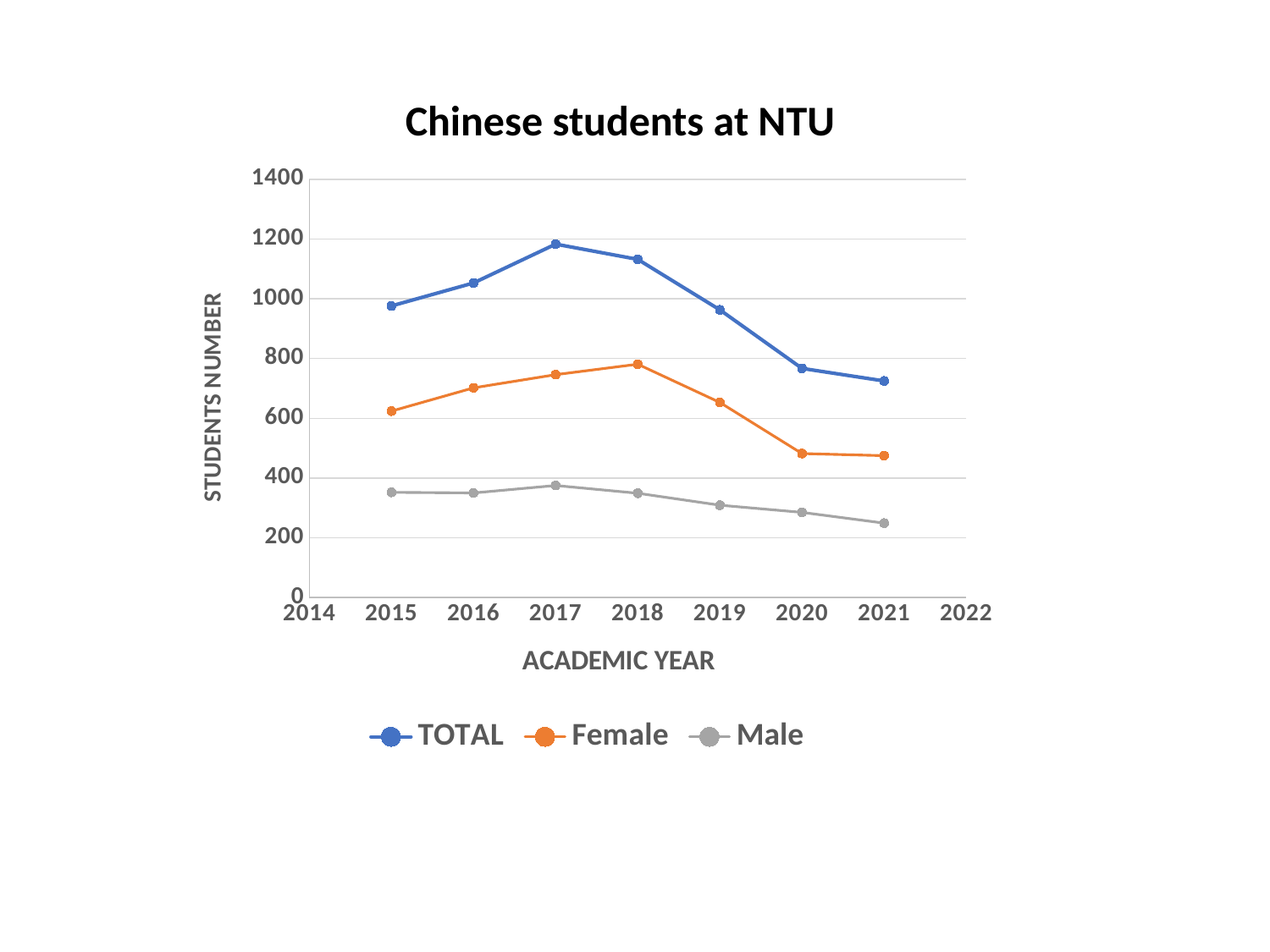
In which academic year does the Female series reach its highest value? 2018 Is the TOTAL value for 2020 greater or less than 800? less Which is larger in 2019, the Female value or the Male value? Female What type of chart is shown on the slide? line chart How many academic years have data points plotted on the chart? 7 How many series does the legend list? 3 Is the Male value for 2021 greater or less than 200? greater In which academic year is the Male series at its lowest? 2021 Is the TOTAL value for 2017 greater or less than 1000? greater In which academic year does the TOTAL series reach its highest value? 2017 Does the TOTAL series rise or fall from 2018 to 2021? fall